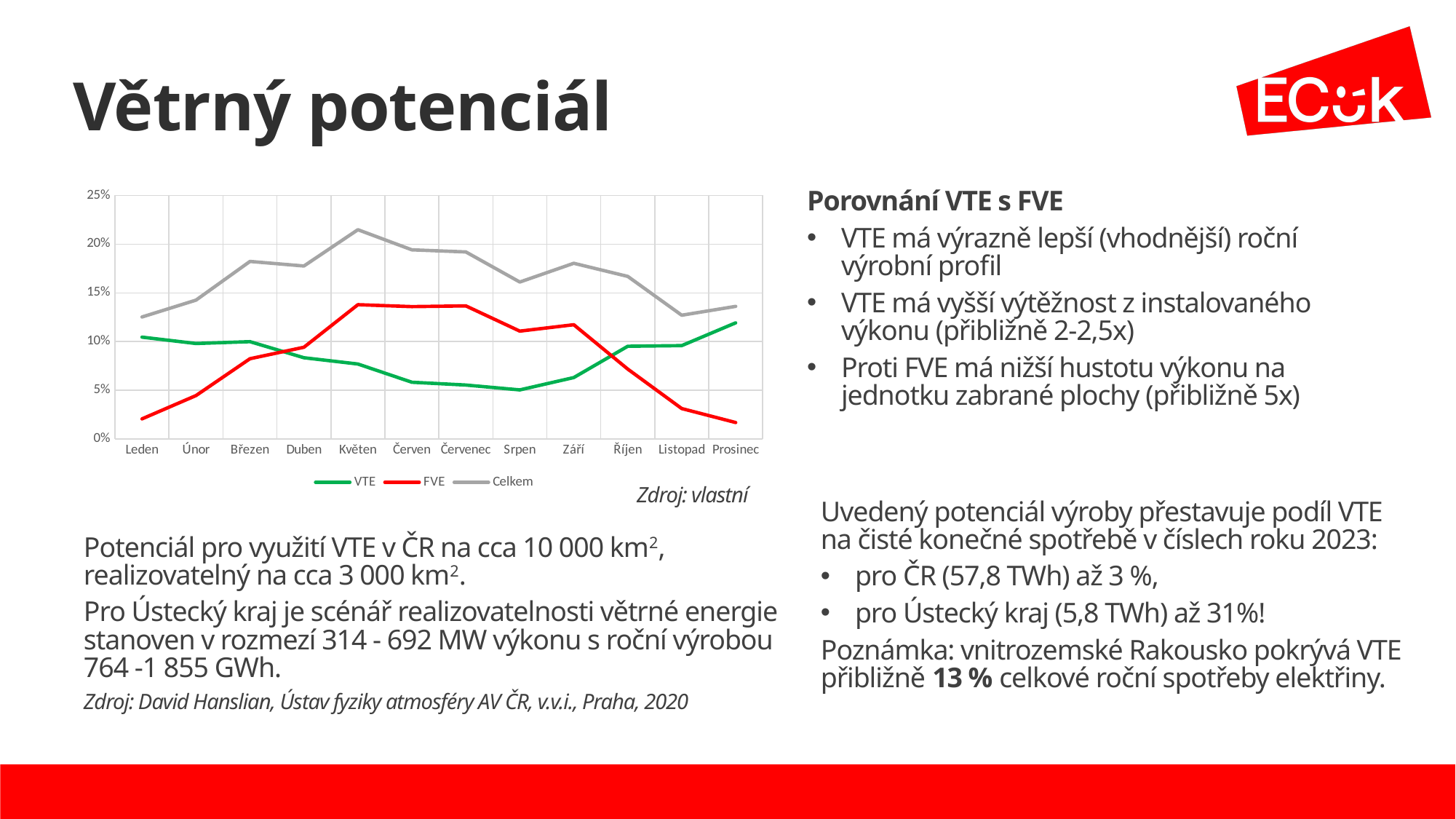
In which month does the VTE series reach its lowest value? Srpen In Květen, which series has the larger value, VTE or FVE? FVE Is the VTE value for Červen greater or less than 10%? less In which month does the VTE series reach its highest value? Prosinec What kind of chart is shown on the slide? line chart How many months are shown on the x axis of the chart? 12 What colour is the VTE line in the chart? green Is the FVE value for Leden greater or less than 5%? less Does the FVE series rise or fall from Leden to Květen? rise How many series does the chart legend list? 3 Is the Celkem value for Květen greater or less than 20%? greater In which month does the Celkem series reach its highest value? Květen